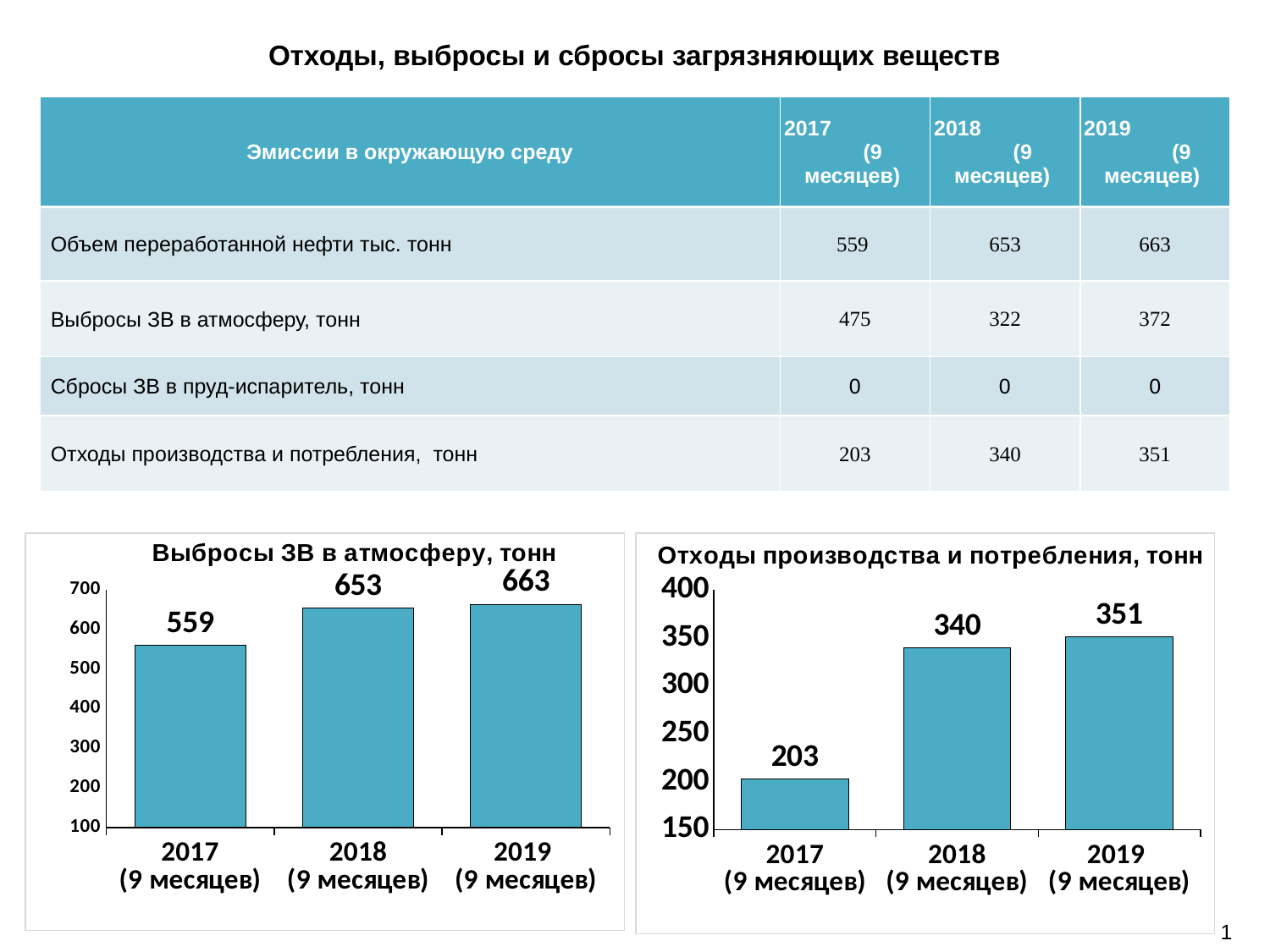
In the chart titled "Отходы производства и потребления, тонн", what is the value for 2018 (9 месяцев)? 340 In the chart titled "Отходы производства и потребления, тонн", what is the difference between the 2018 (9 месяцев) and 2017 (9 месяцев) values? 137 What type of chart is the chart titled "Выбросы ЗВ в атмосферу, тонн"? bar chart In the chart titled "Выбросы ЗВ в атмосферу, тонн", what is the value for 2019 (9 месяцев)? 663 In the chart titled "Отходы производства и потребления, тонн", do the values rise or fall from 2017 to 2019? rise In the chart titled "Выбросы ЗВ в атмосферу, тонн", what is the value for 2017 (9 месяцев)? 559 In the chart titled "Отходы производства и потребления, тонн", which is larger: the value for 2017 (9 месяцев) or 2019 (9 месяцев)? 2019 (9 месяцев) In the chart titled "Выбросы ЗВ в атмосферу, тонн", which year has the highest value? 2019 (9 месяцев) How many bars are shown in the chart titled "Отходы производства и потребления, тонн"? 3 In the chart titled "Выбросы ЗВ в атмосферу, тонн", is the value for 2017 (9 месяцев) greater or less than 600? less In the chart titled "Отходы производства и потребления, тонн", which year has the lowest value? 2017 (9 месяцев) In the chart titled "Выбросы ЗВ в атмосферу, тонн", what is the difference between the 2018 (9 месяцев) and 2017 (9 месяцев) values? 94